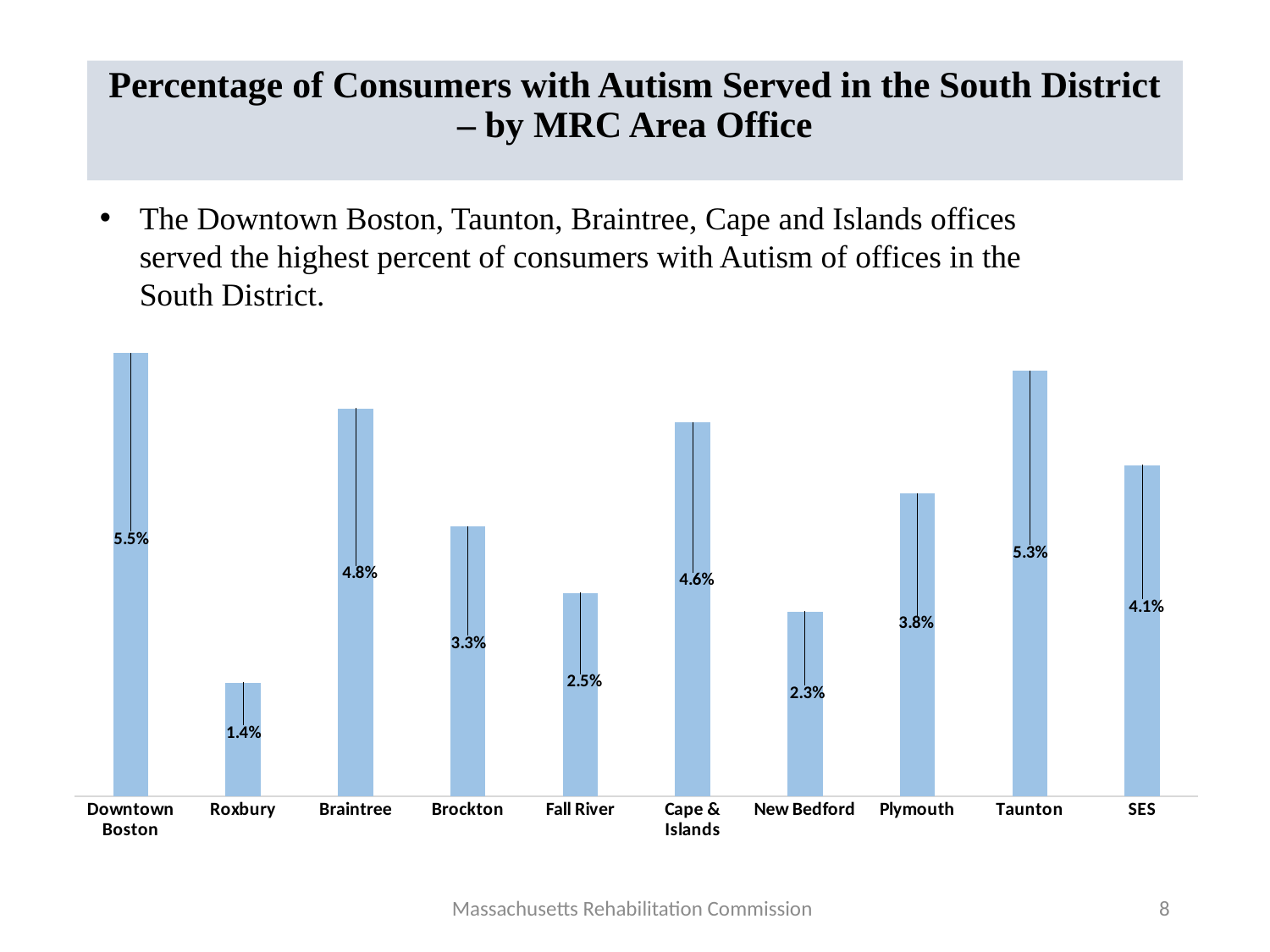
Which MRC area office has the highest percentage of consumers with Autism served? Downtown Boston Which office has a higher percentage, SES or Plymouth? SES Which office has a higher percentage, Fall River or New Bedford? Fall River What percentage is shown for the Cape & Islands office? 4.6% What is the value shown for the Roxbury office? 1.4% What kind of chart is shown on the slide? Bar chart Which MRC area office has the lowest percentage of consumers with Autism served? Roxbury What is the difference between the percentages for Braintree and Brockton? 1.5% What is the title of the slide containing the chart? Percentage of Consumers with Autism Served in the South District – by MRC Area Office What is the difference between the percentages for Taunton and Plymouth? 1.5% How many MRC area offices are shown in the chart? 10 What percentage of consumers with Autism were served by the Downtown Boston office? 5.5%